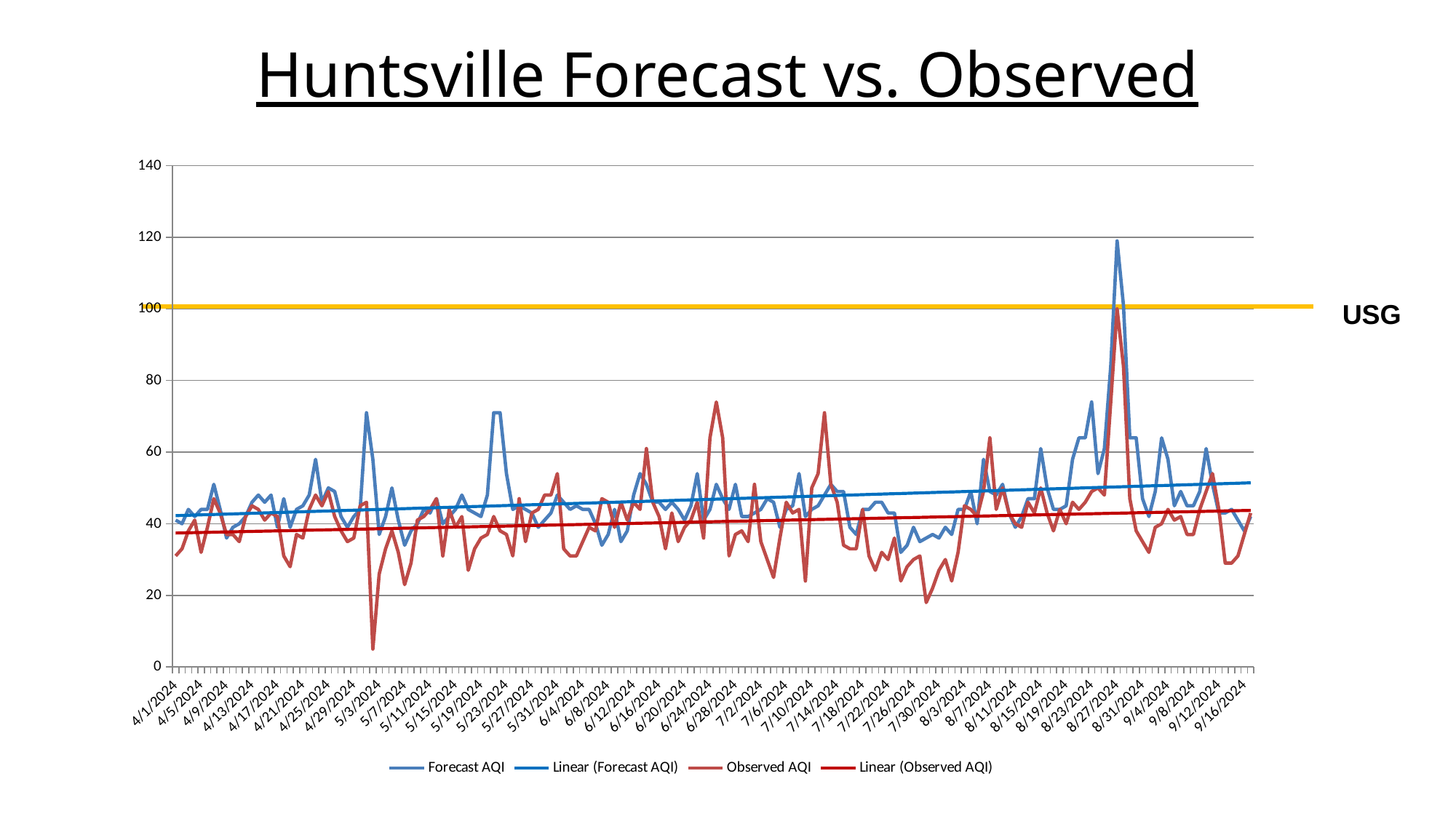
Which series reaches a higher peak value, Forecast AQI or Observed AQI? Forecast AQI What label is attached to the yellow horizontal line? USG Near which labelled date does the Forecast AQI series reach its highest value? 8/27/2024 Is the lowest value of the Observed AQI series greater or less than 20? less What is the title of the chart? Huntsville Forecast vs. Observed Does the Linear (Forecast AQI) trend line rise or fall from left to right? rise What kind of chart is shown on the slide? line chart Is the yellow USG line at a value greater or less than 80? greater Is the peak value of the Forecast AQI series greater or less than 100? greater How many series does the legend list? 4 Does the Linear (Observed AQI) trend line rise or fall from left to right? rise